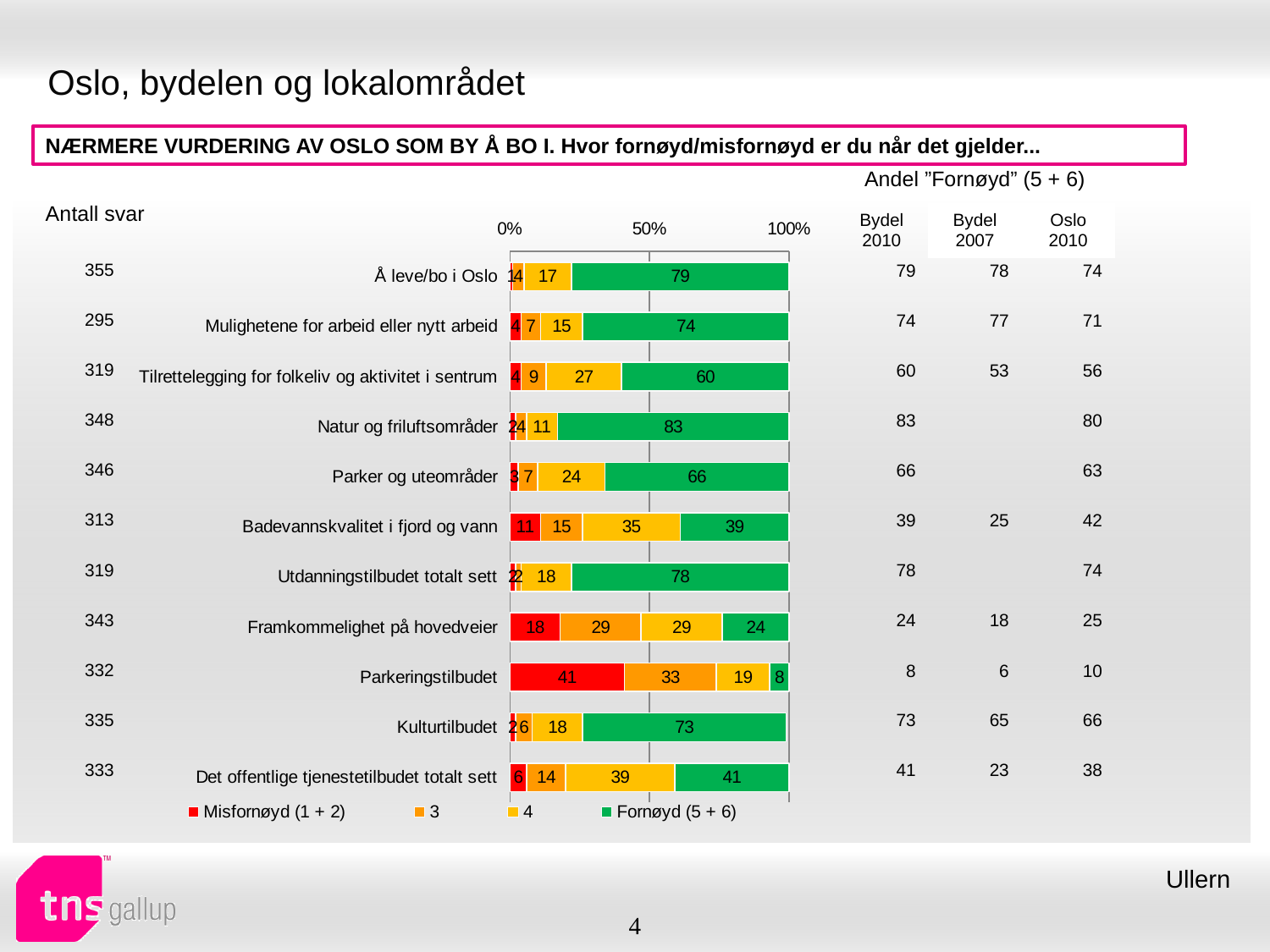
What is the difference between the Fornøyd (5 + 6) values for Å leve/bo i Oslo and Kulturtilbudet? 6 Which has a larger Fornøyd (5 + 6) value, Parker og uteområder or Tilrettelegging for folkeliv og aktivitet i sentrum? Parker og uteområder What is the value of series 3 for Framkommelighet på hovedveier? 29 How many series does the legend list? 4 What is the Misfornøyd (1 + 2) value for Parkeringstilbudet? 41 Which category has the highest Misfornøyd (1 + 2) value? Parkeringstilbudet How many categories are shown in the chart? 11 Which category has the lowest Fornøyd (5 + 6) value? Parkeringstilbudet What is the Fornøyd (5 + 6) value for Natur og friluftsområder? 83 Which category has the highest Fornøyd (5 + 6) value? Natur og friluftsområder What kind of chart is shown on the slide? Stacked bar chart What is the value of series 4 for Badevannskvalitet i fjord og vann? 35